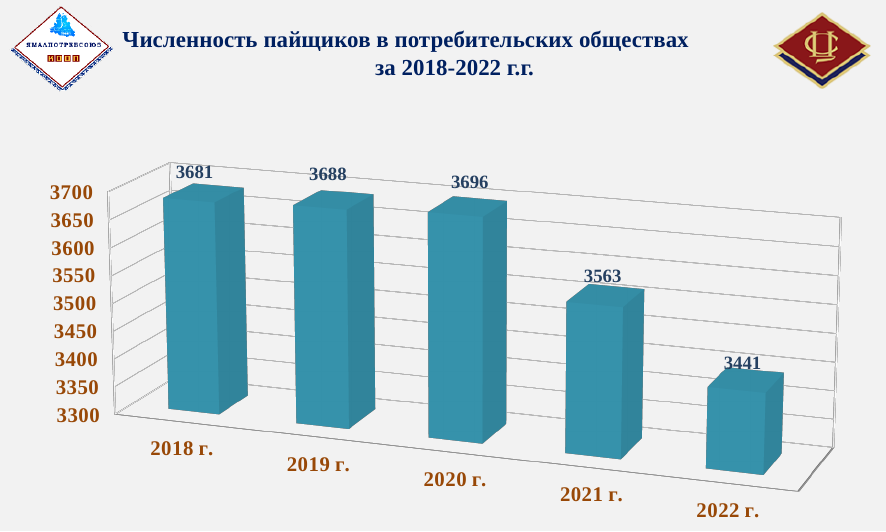
Which year has the highest value? 2020 г. What is the difference between the values for 2020 г. and 2022 г.? 255 What is the value for 2022 г.? 3441 What is the difference between the values for 2019 г. and 2018 г.? 7 Which year has the lowest value? 2022 г. Which is larger, the value for 2021 г. or the value for 2022 г.? 2021 г. What is the title of the chart? Численность пайщиков в потребительских обществах за 2018-2022 г.г. How many years are shown on the chart? 5 What is the value for 2021 г.? 3563 Is the value for 2021 г. greater or less than 3600? less What is the value for 2018 г.? 3681 What kind of chart is shown on the slide? bar chart